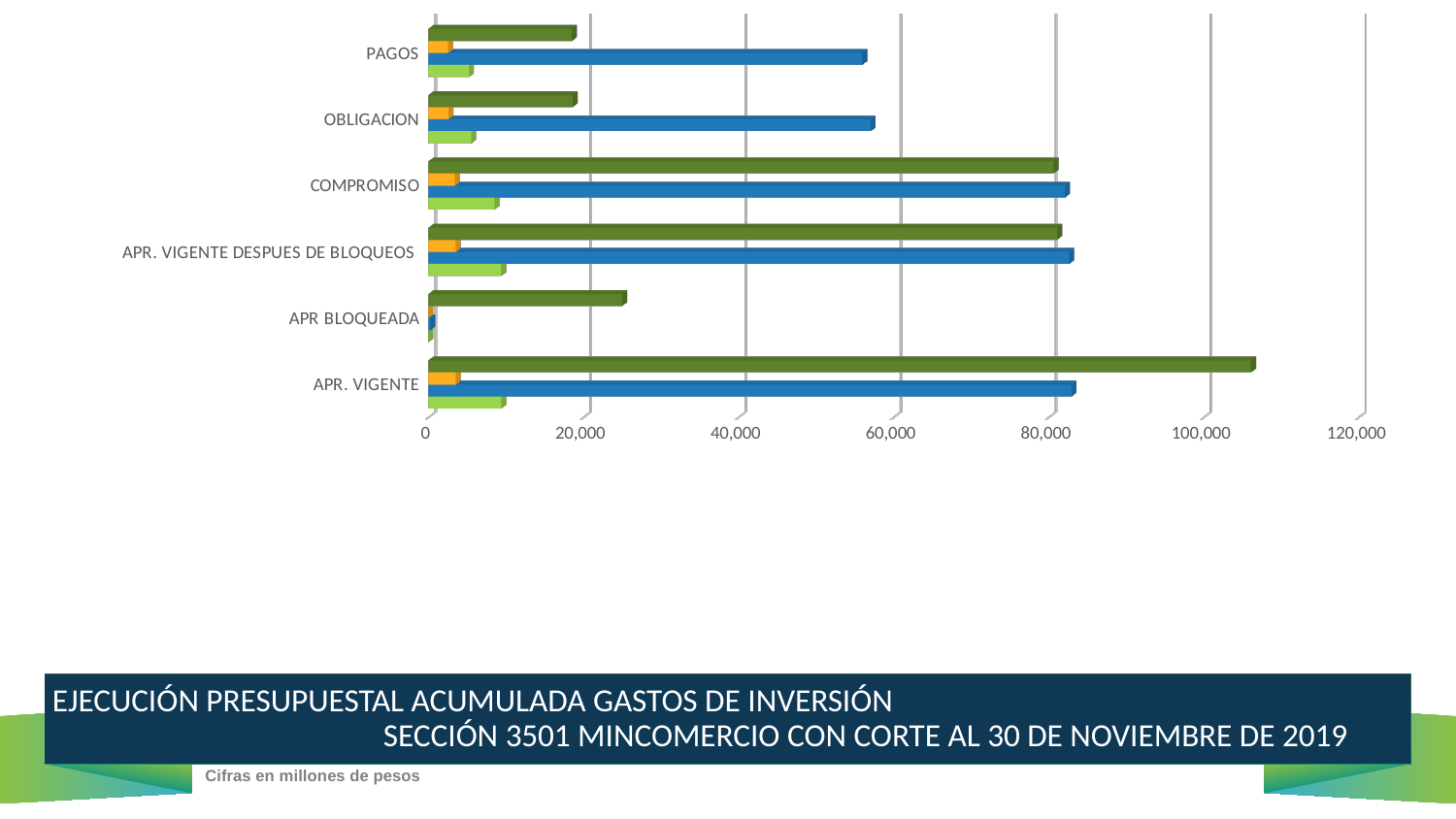
Which has the longer blue bar, PAGOS or COMPROMISO? COMPROMISO What unit note is printed below the chart? Cifras en millones de pesos Is the blue bar for PAGOS greater or less than 60,000? less Is the dark green bar for APR BLOQUEADA greater or less than 20,000? greater How many bars are plotted for each category in the chart? 4 Which category has the longest dark green bar? APR. VIGENTE Is the blue bar for APR BLOQUEADA greater or less than 20,000? less What kind of chart is shown on the slide? Bar chart Which category has the shortest blue bar? APR BLOQUEADA How many categories are shown on the vertical axis of the chart? 6